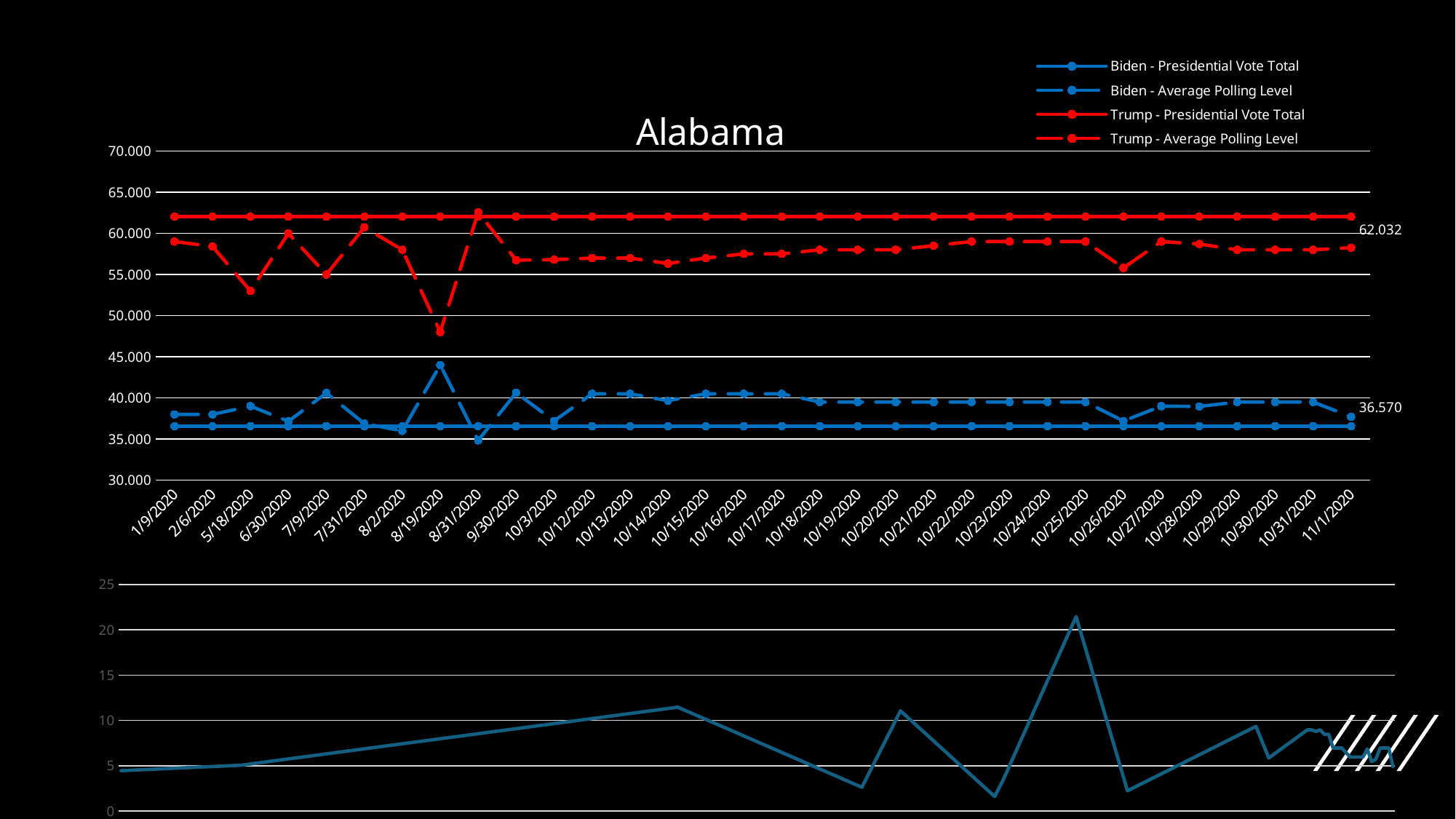
In the top chart titled Alabama, is the Biden - Average Polling Level on 8/19/2020 greater or less than 40.000? greater In the bottom chart, is the highest point of the line greater or less than 20? greater In the top chart titled Alabama, what is the difference between the Trump - Presidential Vote Total (62.032) and the Biden - Presidential Vote Total (36.570)? 25.462 What type of chart is the bottom chart on the slide? line chart How many dates are shown on the x axis of the top chart titled Alabama? 32 In the top chart titled Alabama, which is larger: the Trump - Presidential Vote Total or the Biden - Presidential Vote Total? Trump - Presidential Vote Total What type of chart is the top chart titled Alabama? line chart How many series does the legend of the top chart list? 4 In the top chart titled Alabama, is the Trump - Average Polling Level on 8/19/2020 greater or less than 50.000? less In the top chart titled Alabama, what is the labelled value of the Trump - Presidential Vote Total series? 62.032 What is the title of the top chart? Alabama In the top chart titled Alabama, what is the labelled value of the Biden - Presidential Vote Total series? 36.570